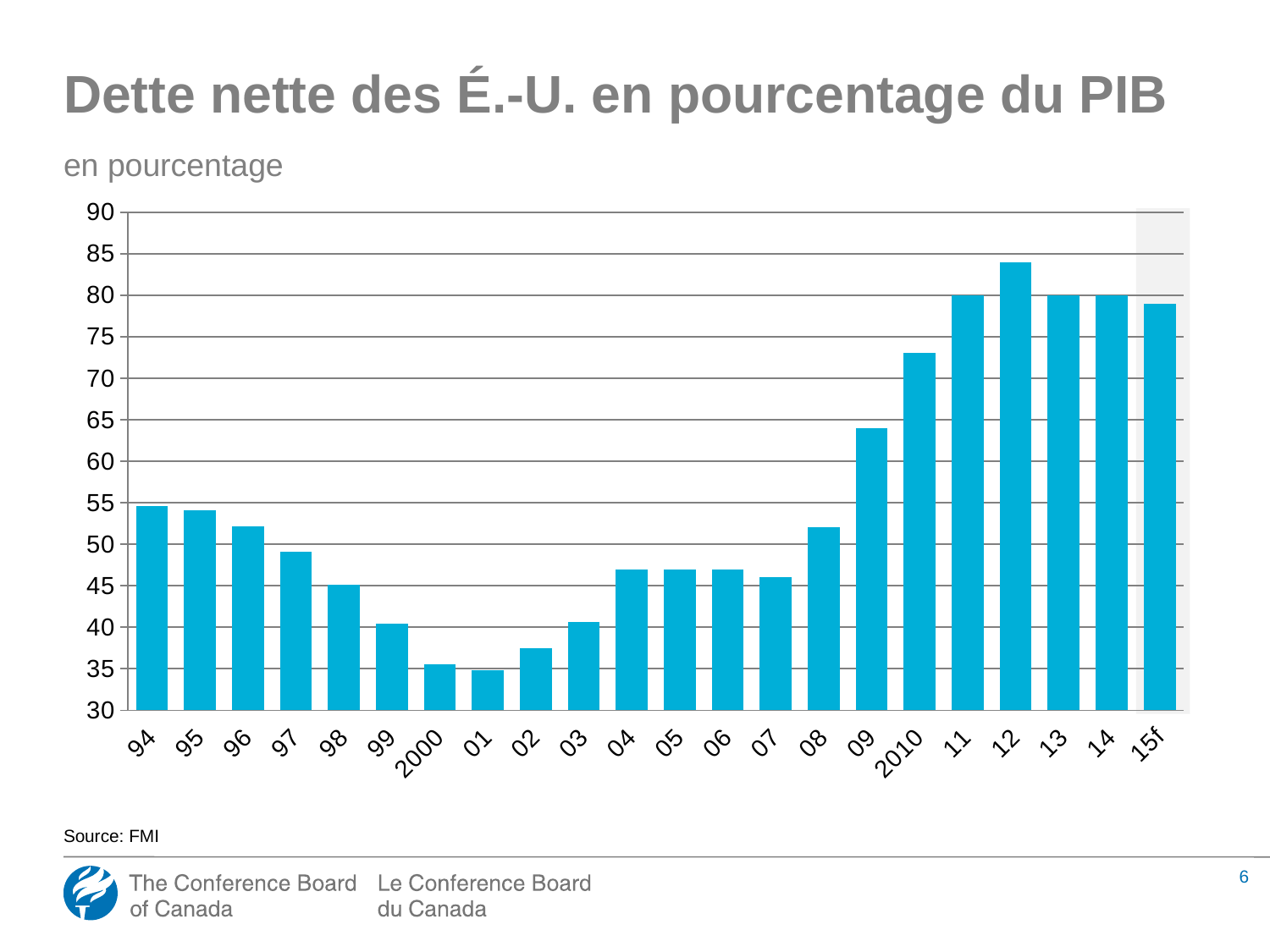
Is the value for 2010 greater or less than 70? greater Which year has the highest net debt as a percentage of GDP? 12 Which year has the lowest net debt as a percentage of GDP? 01 What is the value for 11? 80 Is the value for 02 greater or less than 40? less Which is larger, the value for 94 or the value for 08? 94 What kind of chart is shown on the slide? bar chart Is the value for 09 greater or less than 60? greater How many bars (years) are plotted in the chart? 22 Do the values rise or fall from 94 to 01? fall What source is cited for the chart? FMI